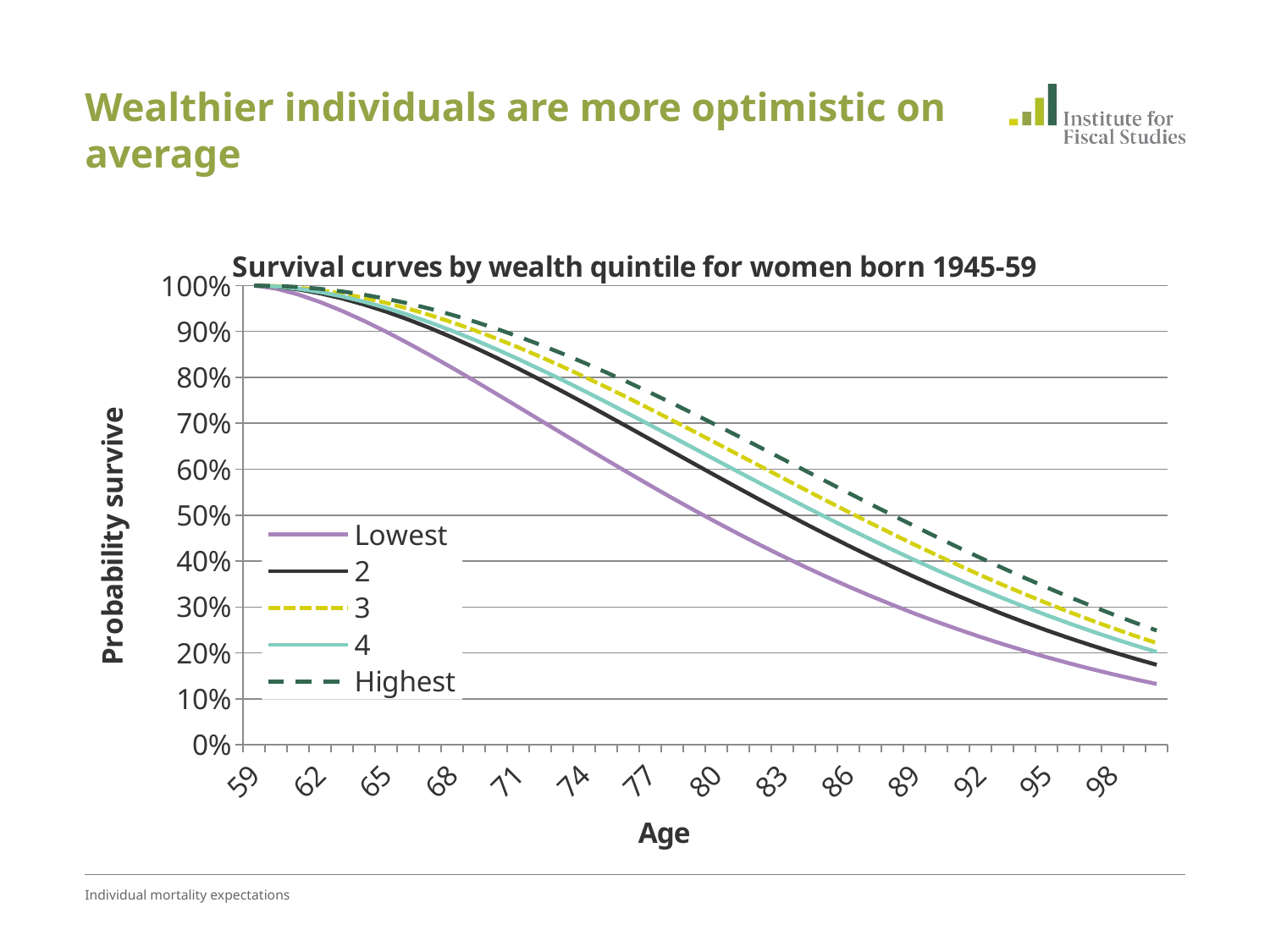
Is the value for the Highest quintile at age 98 greater or less than 20%? greater Do the survival probabilities rise or fall as age increases? fall What is the title of the chart? Survival curves by wealth quintile for women born 1945-59 What kind of chart is shown on the slide? line chart Is the value for the Lowest quintile at age 98 greater or less than 20%? less Is the value for quintile 2 at age 95 greater or less than 30%? less How many series does the legend list? 5 At age 80, which has the larger survival probability, the Highest quintile or the Lowest quintile? Highest Which series has the lowest survival probability at age 98? Lowest What is the label on the vertical axis? Probability survive